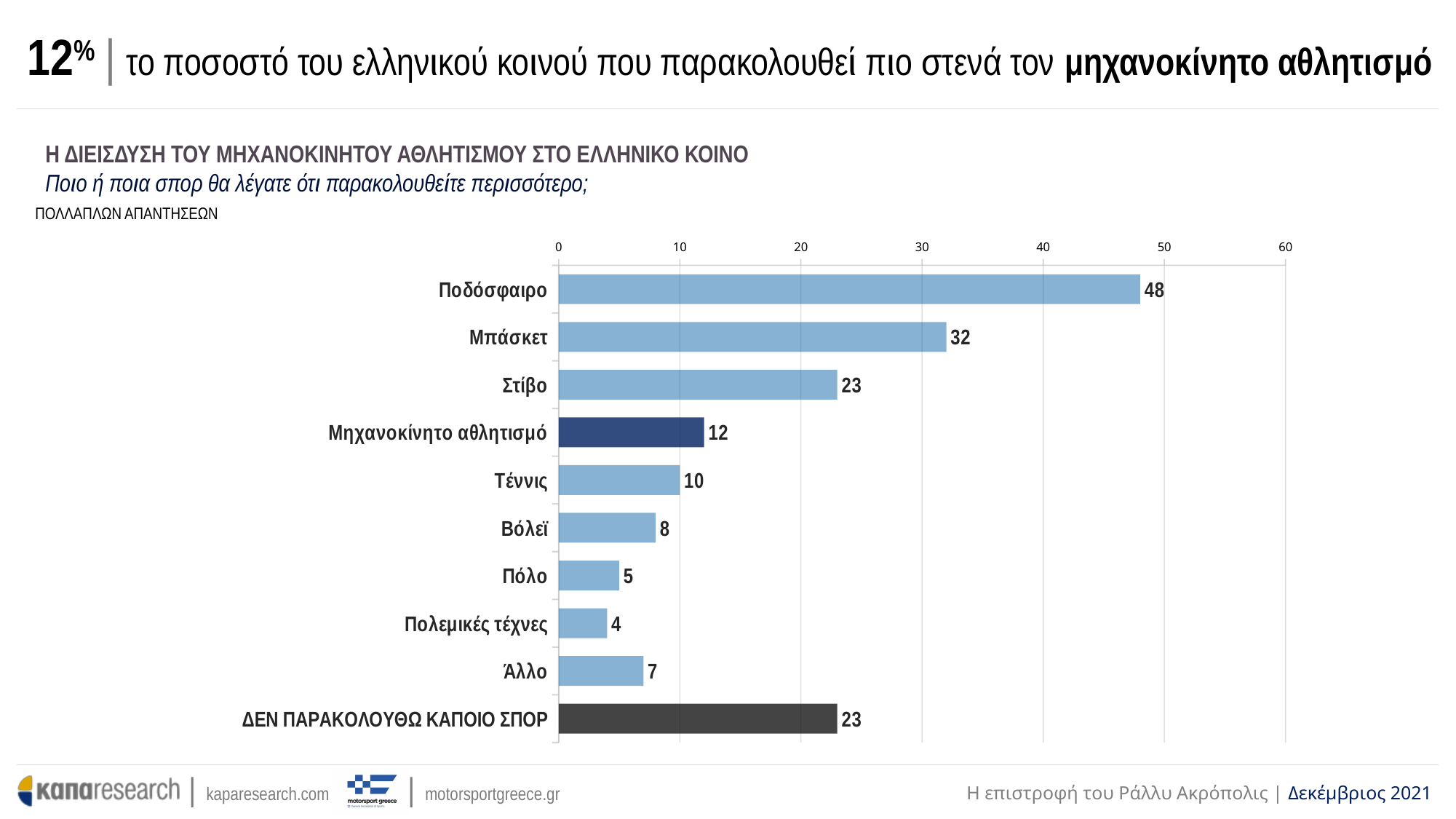
Which is larger, the value for Τέννις or the value for Βόλεϊ? Τέννις Which category has the highest value? Ποδόσφαιρο Is the value for Μπάσκετ greater or less than 30? greater What is the value for ΔΕΝ ΠΑΡΑΚΟΛΟΥΘΩ ΚΑΠΟΙΟ ΣΠΟΡ? 23 What is the value for Πολεμικές τέχνες? 4 Which bar is drawn in dark blue, different from the light blue of most bars? Μηχανοκίνητο αθλητισμό What is the value for Ποδόσφαιρο? 48 How many categories are shown in the chart? 10 Which category has the lowest value? Πολεμικές τέχνες What is the difference between the values for Ποδόσφαιρο and Μπάσκετ? 16 What is the value for Μηχανοκίνητο αθλητισμό? 12 What kind of chart is shown on the slide? bar chart